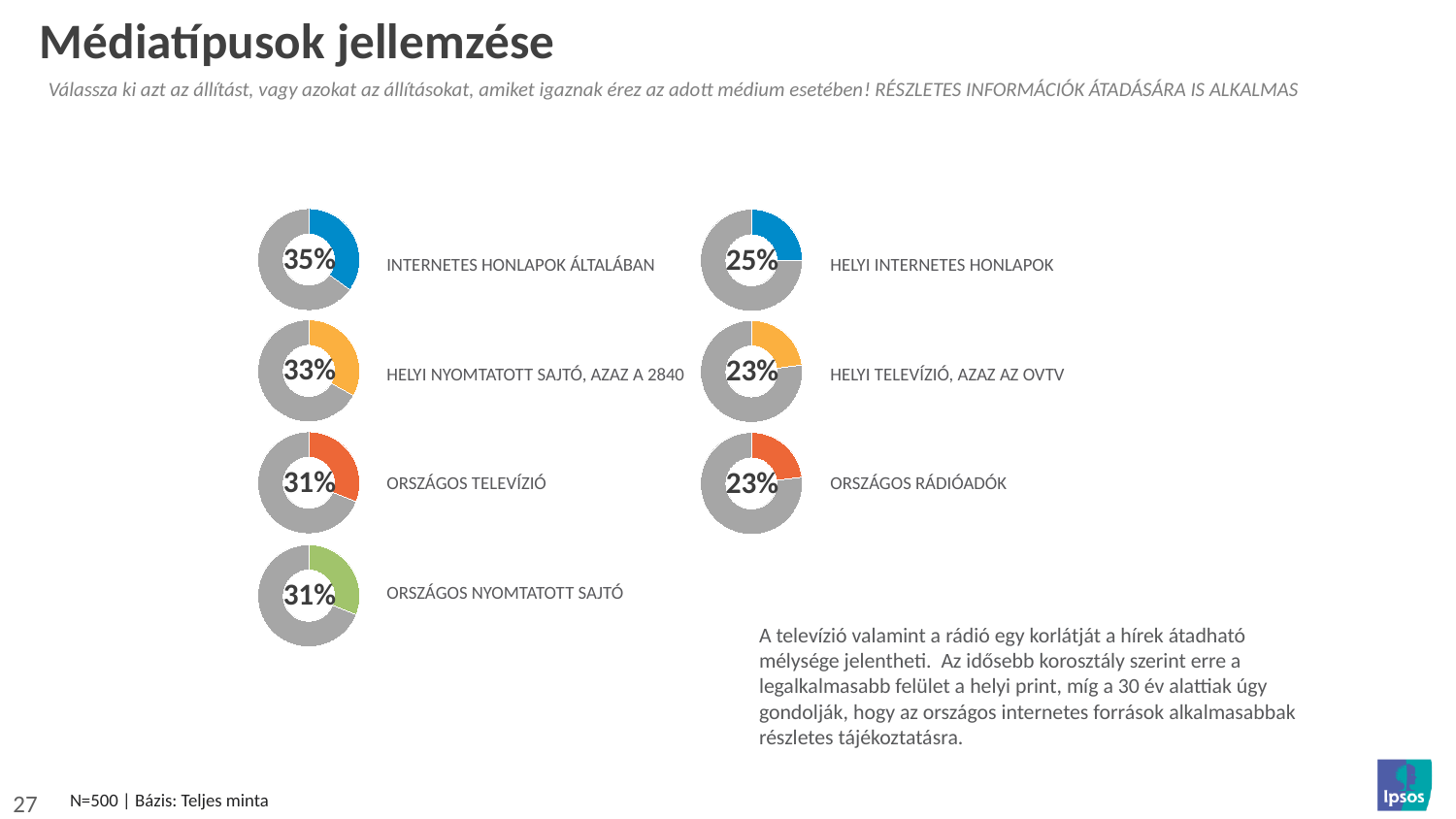
Which is larger: the percentage for ORSZÁGOS TELEVÍZIÓ or the percentage for HELYI TELEVÍZIÓ, AZAZ AZ OVTV? ORSZÁGOS TELEVÍZIÓ What percentage is shown in the donut chart labelled INTERNETES HONLAPOK ÁLTALÁBAN? 35% What percentage is shown in the donut chart labelled HELYI NYOMTATOTT SAJTÓ, AZAZ A 2840? 33% What is the difference between the percentage for INTERNETES HONLAPOK ÁLTALÁBAN and the percentage for HELYI INTERNETES HONLAPOK? 10% Which medium has the highest percentage among the donut charts on the slide? INTERNETES HONLAPOK ÁLTALÁBAN What colour is the highlighted segment in the donut chart for ORSZÁGOS NYOMTATOTT SAJTÓ? Green What percentage is shown in the donut chart labelled ORSZÁGOS RÁDIÓADÓK? 23% What percentage is shown in the donut chart labelled HELYI INTERNETES HONLAPOK? 25% What kind of chart is used to show the percentage for each medium on the slide? Donut chart What is the difference between the percentage for HELYI NYOMTATOTT SAJTÓ, AZAZ A 2840 and the percentage for ORSZÁGOS RÁDIÓADÓK? 10% What percentage is shown in the donut chart labelled ORSZÁGOS NYOMTATOTT SAJTÓ? 31% How many donut charts are shown on the slide? 7